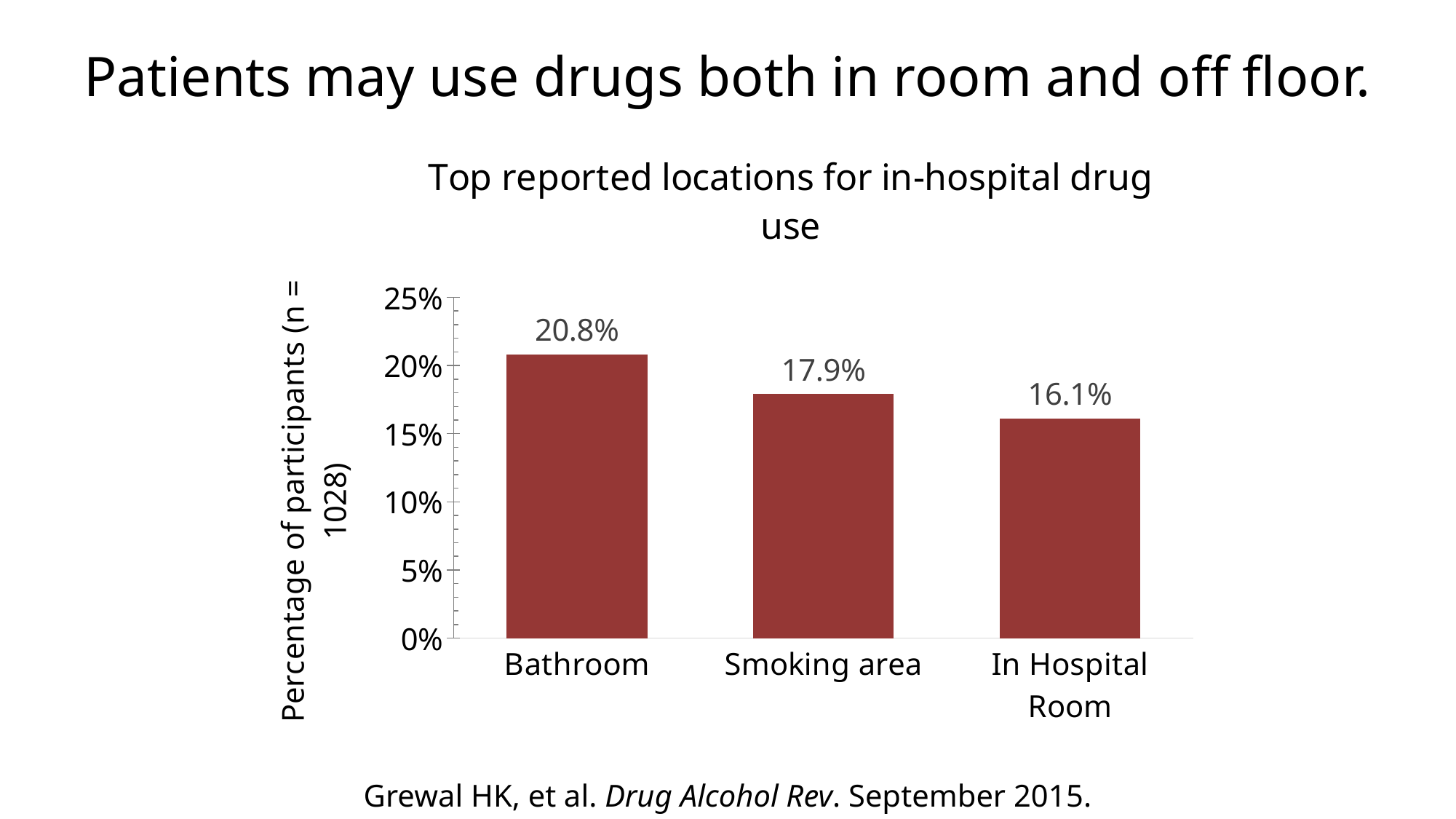
What kind of chart is shown on the slide? Bar chart What is the value for Smoking area? 17.9% What is the value for In Hospital Room? 16.1% Which is larger, the value for Smoking area or the value for In Hospital Room? Smoking area How many locations are shown in the chart? 3 Which location has the highest reported percentage? Bathroom What is the difference between the Bathroom and In Hospital Room percentages? 4.7% Which location has the lowest reported percentage? In Hospital Room What is the difference between the Smoking area and In Hospital Room percentages? 1.8% What percentage of participants reported the Bathroom as a location for in-hospital drug use? 20.8% Is the value for Bathroom greater or less than 20%? greater What is the title of the chart? Top reported locations for in-hospital drug use